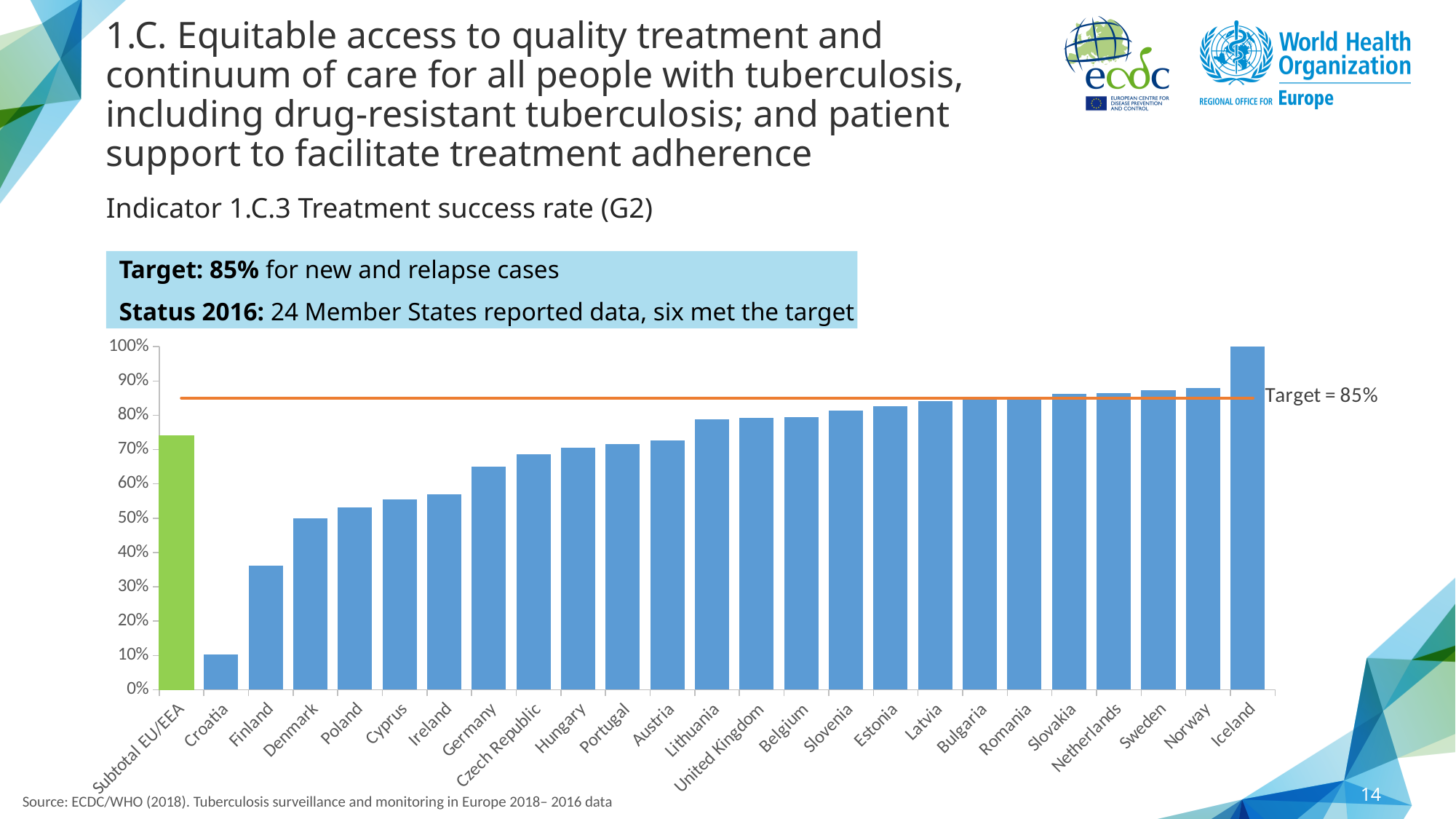
Which has the larger treatment success rate, Hungary or Lithuania? Lithuania What kind of chart is shown on the slide? bar chart Is the value for Germany greater or less than 60%? greater Which country has the lowest treatment success rate in the chart? Croatia How many bars are plotted in the chart? 25 Is the value for Finland greater or less than 40%? less What is the treatment success rate for Iceland? 100% Is the value for Norway greater or less than 85%? greater Excluding the Subtotal EU/EEA bar, do the values rise or fall from Croatia on the left to Iceland on the right? rise What target value does the horizontal line on the chart mark? 85% Which country has the highest treatment success rate in the chart? Iceland